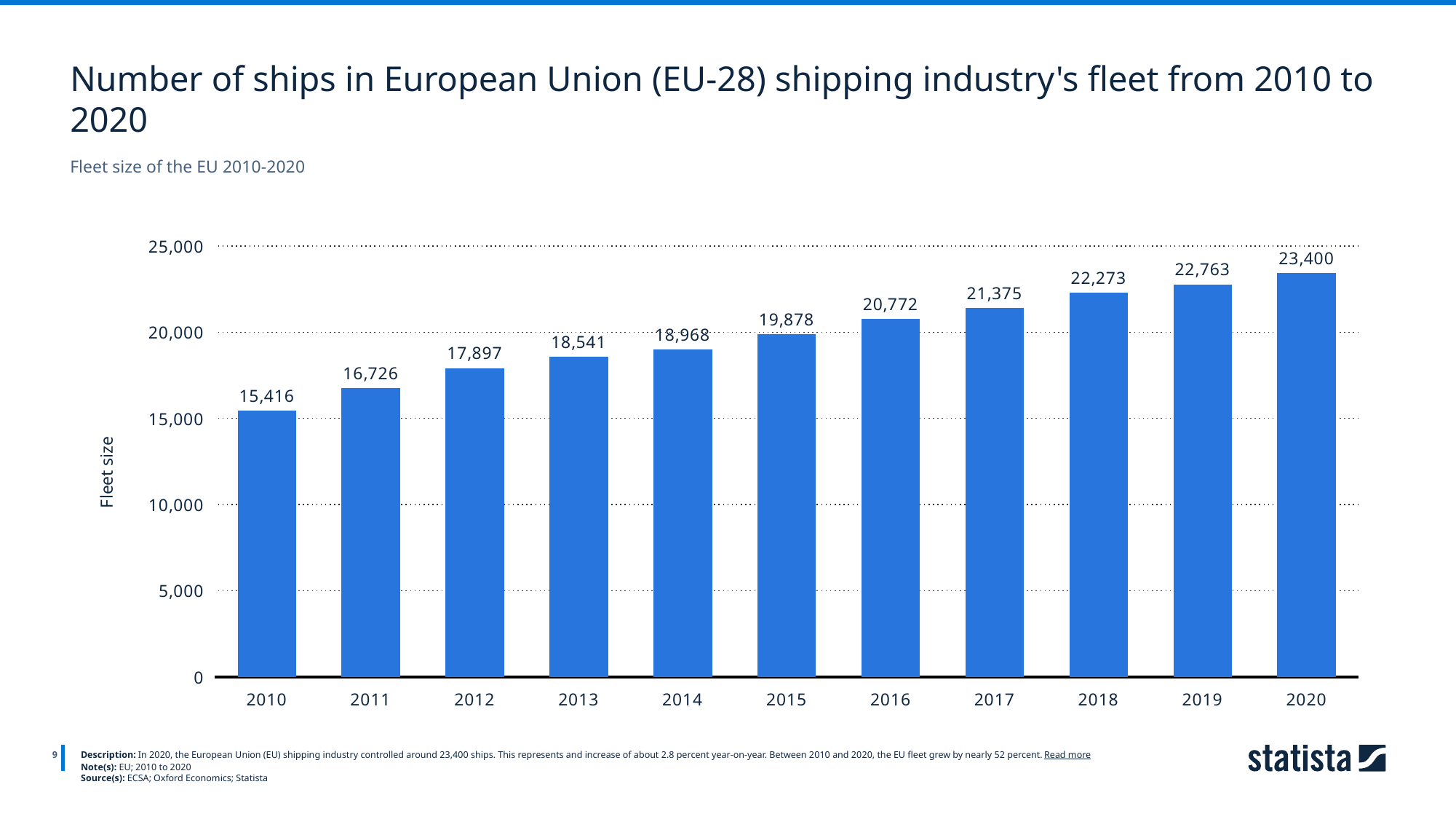
Which year has the lowest fleet size? 2010 Which year has the highest fleet size? 2020 What is the difference in fleet size between 2020 and 2010? 7,984 What kind of chart is shown on the slide? Bar chart Which year had a larger fleet size, 2012 or 2016? 2016 Does the fleet size rise or fall from 2010 to 2020? Rise What was the fleet size of the EU in 2010? 15,416 What was the fleet size of the EU in 2018? 22,273 Is the fleet size for 2017 greater or less than 20,000? greater What was the fleet size of the EU in 2015? 19,878 How many years are shown on the x axis? 11 What is the difference in fleet size between 2014 and 2013? 427